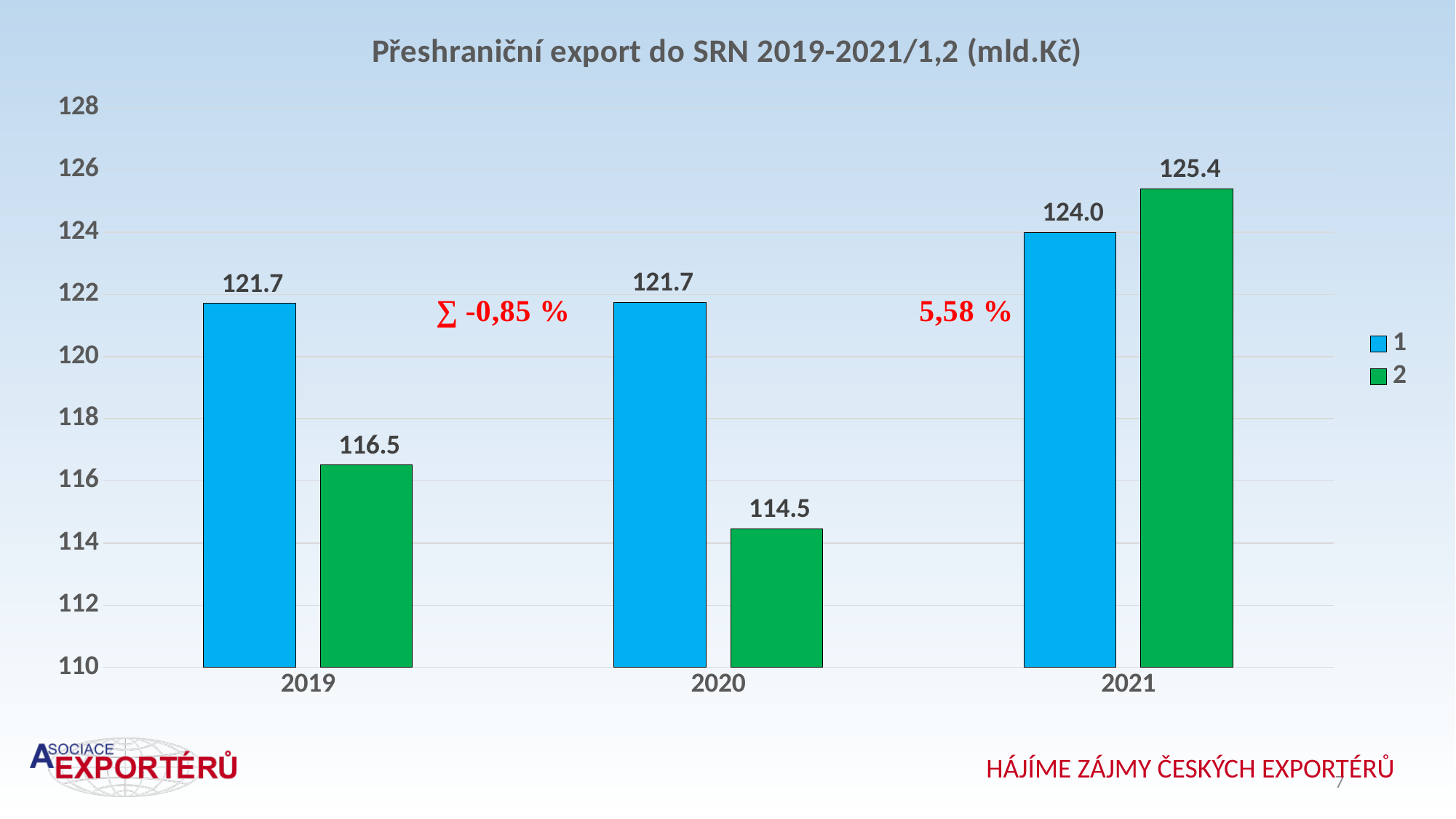
What is the value for series 1 in 2019? 121.7 How many years are shown on the x axis? 3 Which year has the lowest value for series 2? 2020 What is the title of the chart? Přeshraniční export do SRN 2019-2021/1,2 (mld.Kč) What is the value for series 2 in 2020? 114.5 What kind of chart is shown on the slide? bar chart Which is larger in 2021, series 1 or series 2? 2 What is the value for series 2 in 2021? 125.4 What is the difference between series 1 and series 2 in 2019? 5.2 What is the value for series 1 in 2021? 124.0 Which year has the highest value for series 2? 2021 How many series does the legend list? 2